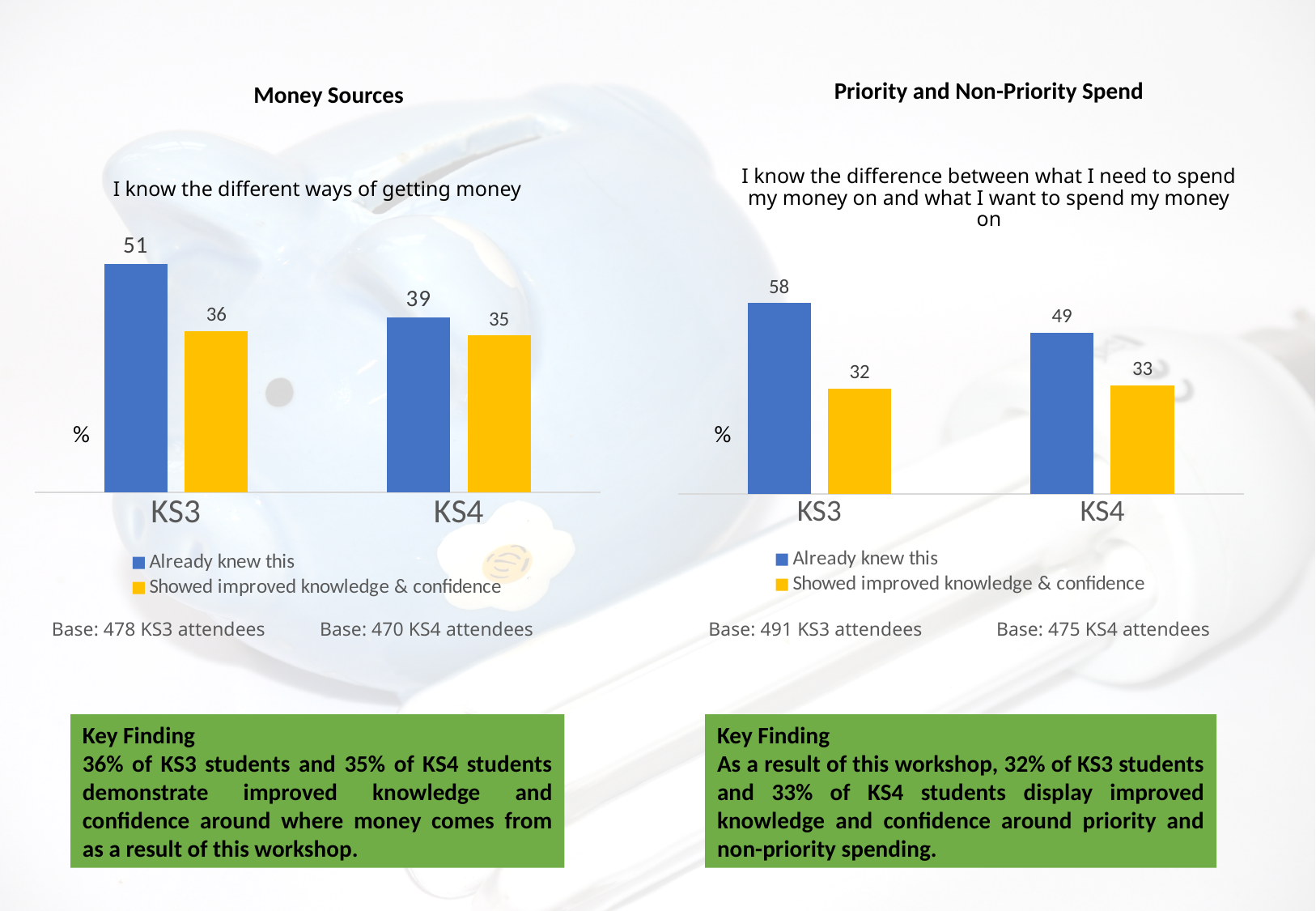
In the Money Sources chart, what is the difference between 'Already knew this' and 'Showed improved knowledge & confidence' for KS3? 15 In the Money Sources chart, which bar has the highest value? Already knew this, KS3 In the Money Sources chart, what is the value for 'Showed improved knowledge & confidence' for KS4? 35 In the Priority and Non-Priority Spend chart, what is the value for 'Showed improved knowledge & confidence' for KS3? 32 How many categories are shown on the x axis of the Priority and Non-Priority Spend chart? 2 In the Priority and Non-Priority Spend chart, which is larger: 'Already knew this' for KS3 or 'Already knew this' for KS4? KS3 In the Priority and Non-Priority Spend chart, what is the difference between 'Already knew this' for KS3 and for KS4? 9 How many series does the legend of the Money Sources chart list? 2 What type of chart is the Money Sources chart? Bar chart In the Priority and Non-Priority Spend chart, which bar has the lowest value? Showed improved knowledge & confidence, KS3 In the Money Sources chart, what is the value for 'Already knew this' for KS3? 51 In the Priority and Non-Priority Spend chart, what is the value for 'Already knew this' for KS4? 49